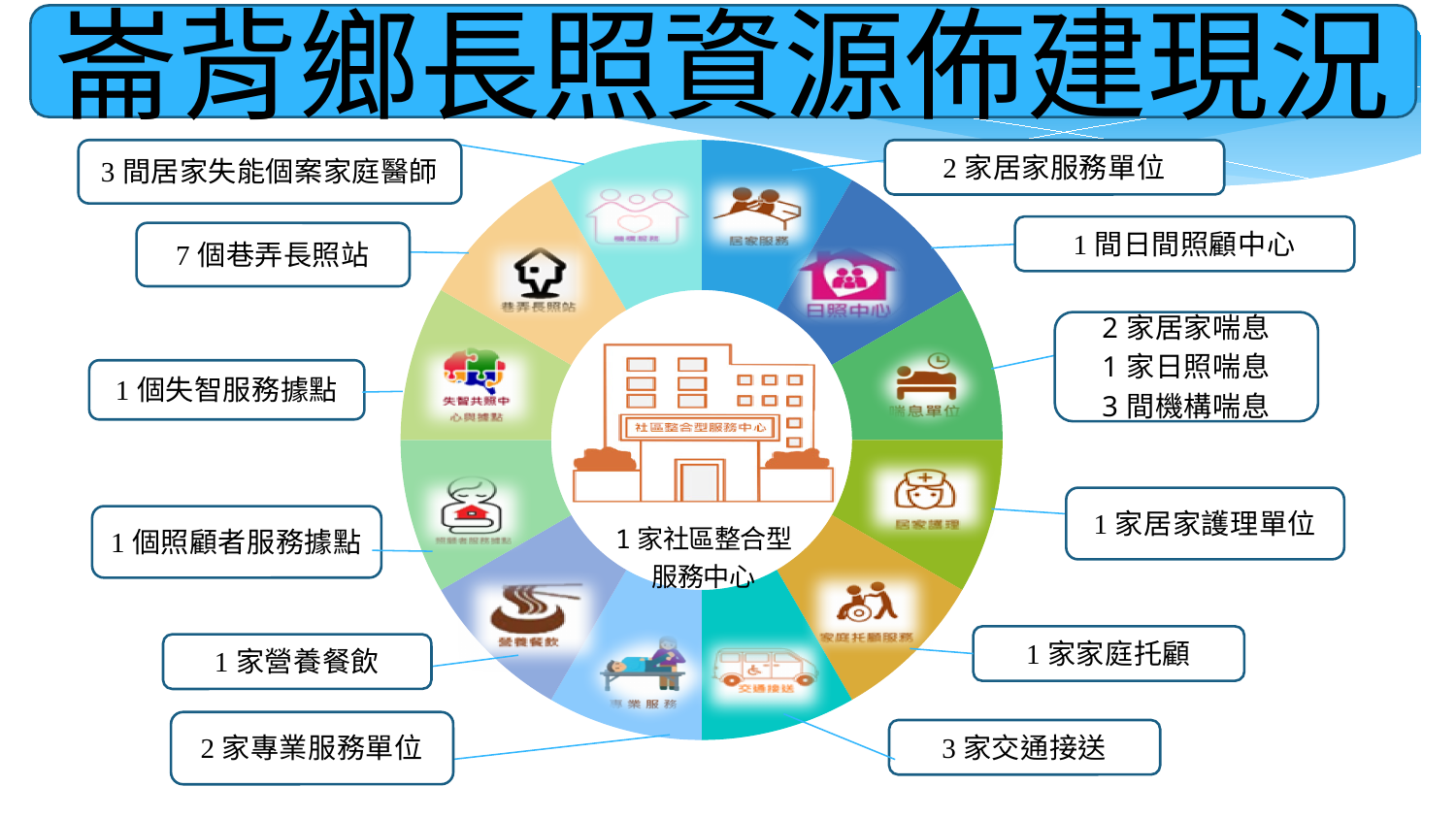
What is the title of the diagram on the slide? 崙背鄉長照資源佈建現況 How many 交通接送 providers are shown on the slide? 3 家 How many 居家失能個案家庭醫師 are shown on the slide? 3 間 How many 專業服務單位 are shown on the slide? 2 家 How many 日間照顧中心 are shown on the slide? 1 間 What is the difference between the number of 巷弄長照站 and the number of 交通接送? 4 How many 機構喘息 are shown on the slide? 3 間 Which resource type has the highest count on the slide? 巷弄長照站 How many segments does the ring diagram around the centre contain? 12 What is shown in the centre of the ring diagram? 1 家社區整合型服務中心 Which is larger, the number of 交通接送 or the number of 專業服務單位? 交通接送 How many 巷弄長照站 are shown on the slide? 7 個